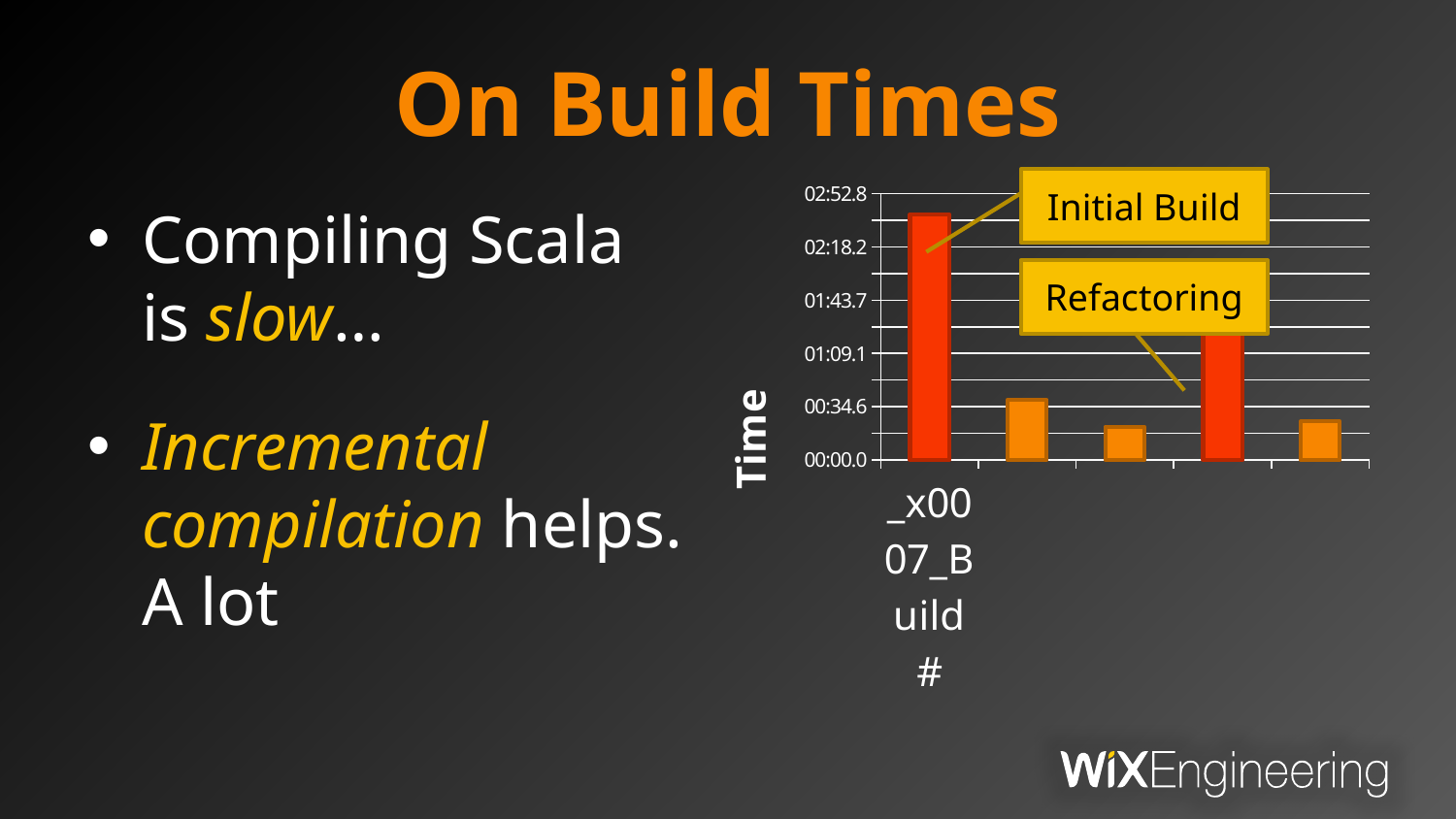
Which is larger, the second bar or the third bar? the second bar Is the value of the second bar greater or less than 00:34.6? greater Is the value of the third bar greater or less than 00:34.6? less What is the title of the vertical axis of the chart? Time Which bar in the chart is the tallest? the first bar (Initial Build) How many bars are plotted in the chart? 5 What label does the callout pointing to the first bar show? Initial Build Is the value of the fourth bar (Refactoring) greater or less than 01:09.1? greater Which is larger, the first bar (Initial Build) or the fourth bar (Refactoring)? the first bar (Initial Build) What kind of chart is shown on the slide? bar chart